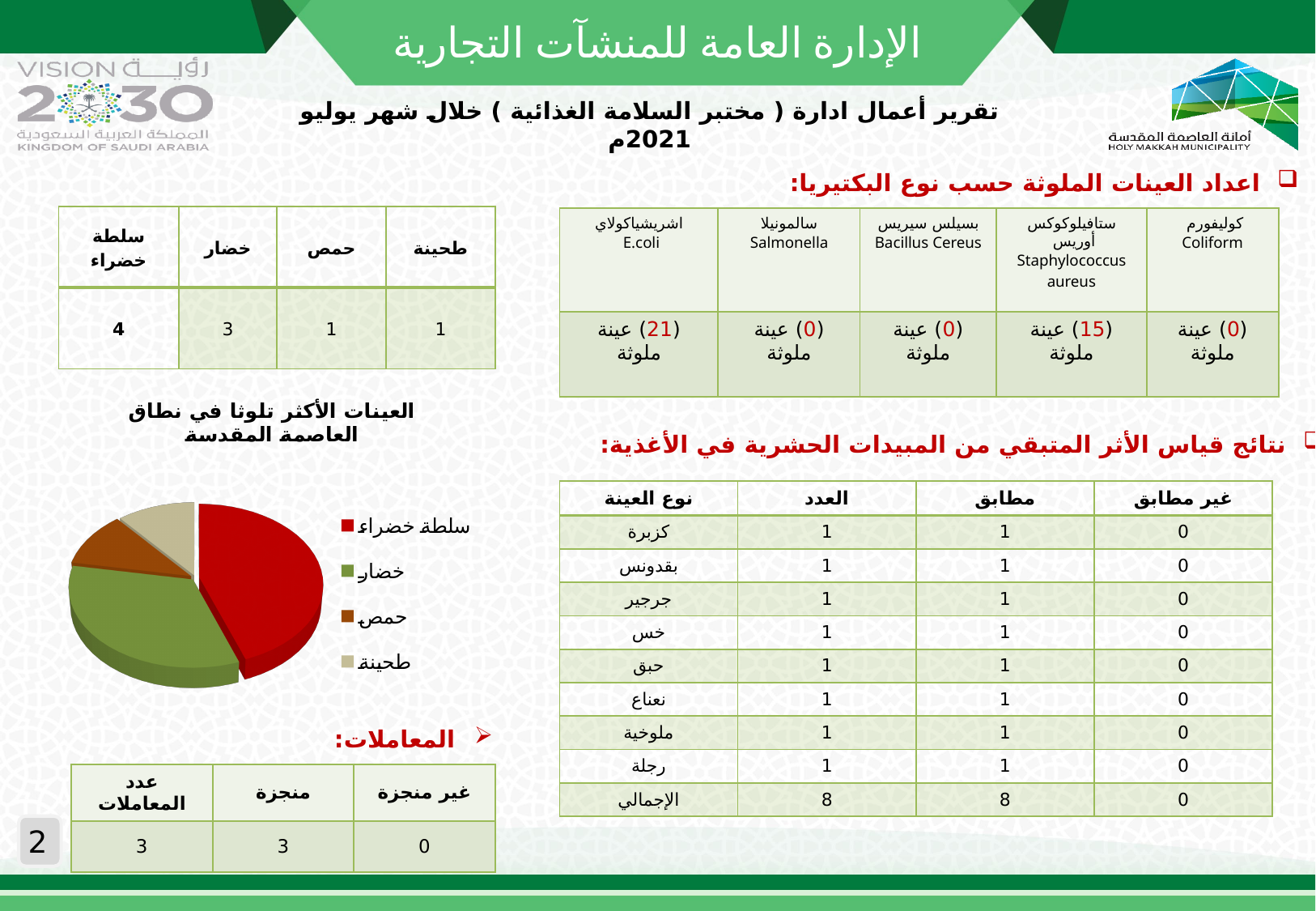
What is the title of the pie chart? العينات الأكثر تلوثا في نطاق العاصمة المقدسة In the pie chart, which slice is larger: خضار or طحينة? خضار Which category has the largest slice in the pie chart? سلطة خضراء In the pie chart, which slice is larger: سلطة خضراء or حمص? سلطة خضراء What kind of chart is shown on the slide? pie chart How many slices does the pie chart have? 4 In the pie chart, which slice is larger: سلطة خضراء or طحينة? سلطة خضراء What colour represents سلطة خضراء in the pie chart legend? red How many entries does the legend of the pie chart list? 4